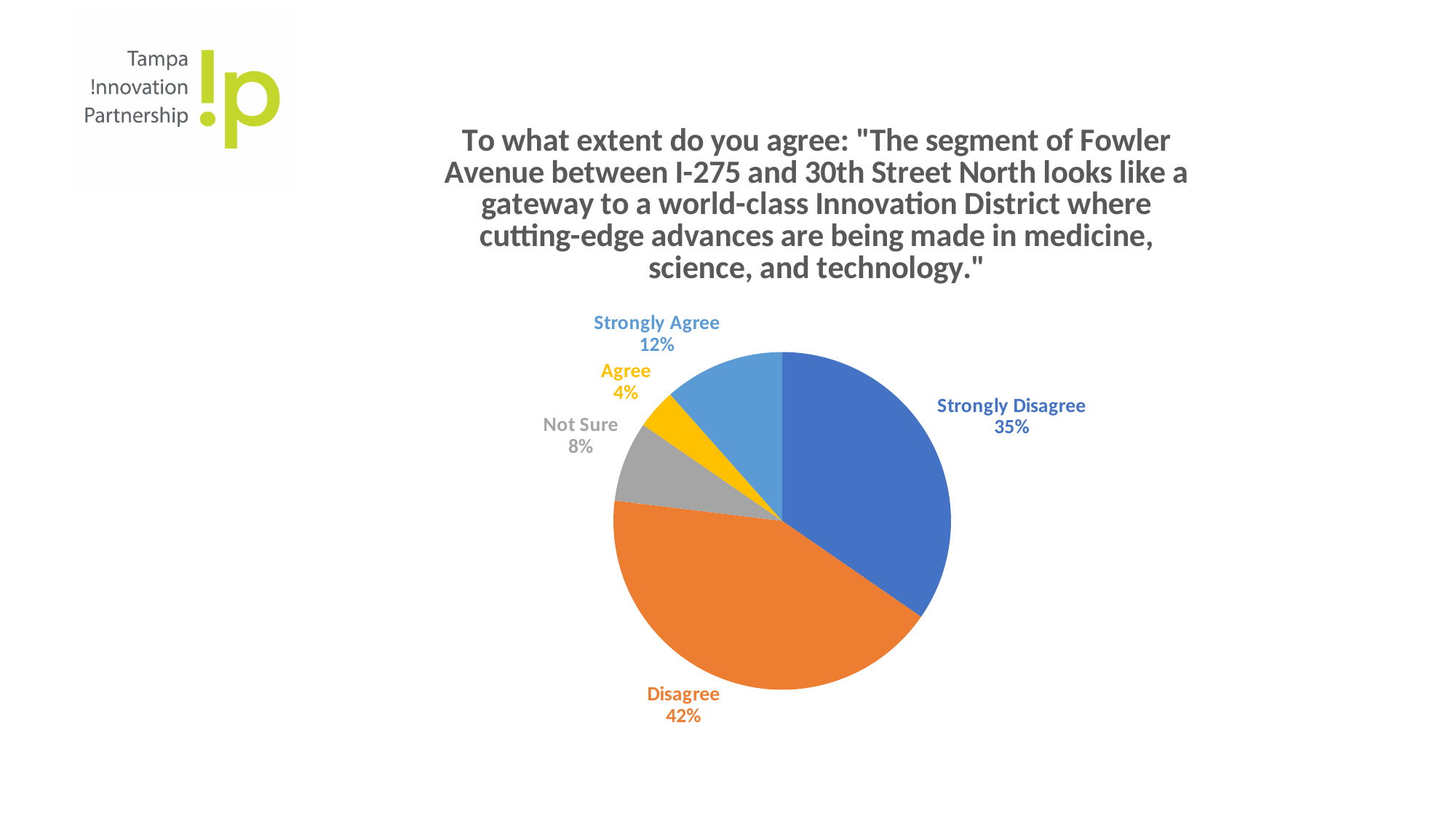
What percentage of respondents answered Not Sure? 8% What is the combined share of Strongly Disagree and Disagree? 77% What percentage of respondents answered Strongly Agree? 12% What colour is the Disagree slice of the pie? Orange What kind of chart is shown on the slide? Pie chart What percentage of respondents answered Agree? 4% Which is larger, the share for Strongly Agree or the share for Not Sure? Strongly Agree Which response category has the smallest share of the pie? Agree What percentage of respondents answered Disagree? 42% What is the difference in percentage points between Disagree and Strongly Disagree? 7 How many response categories are shown in the pie chart? 5 Which response category has the largest share of the pie? Disagree